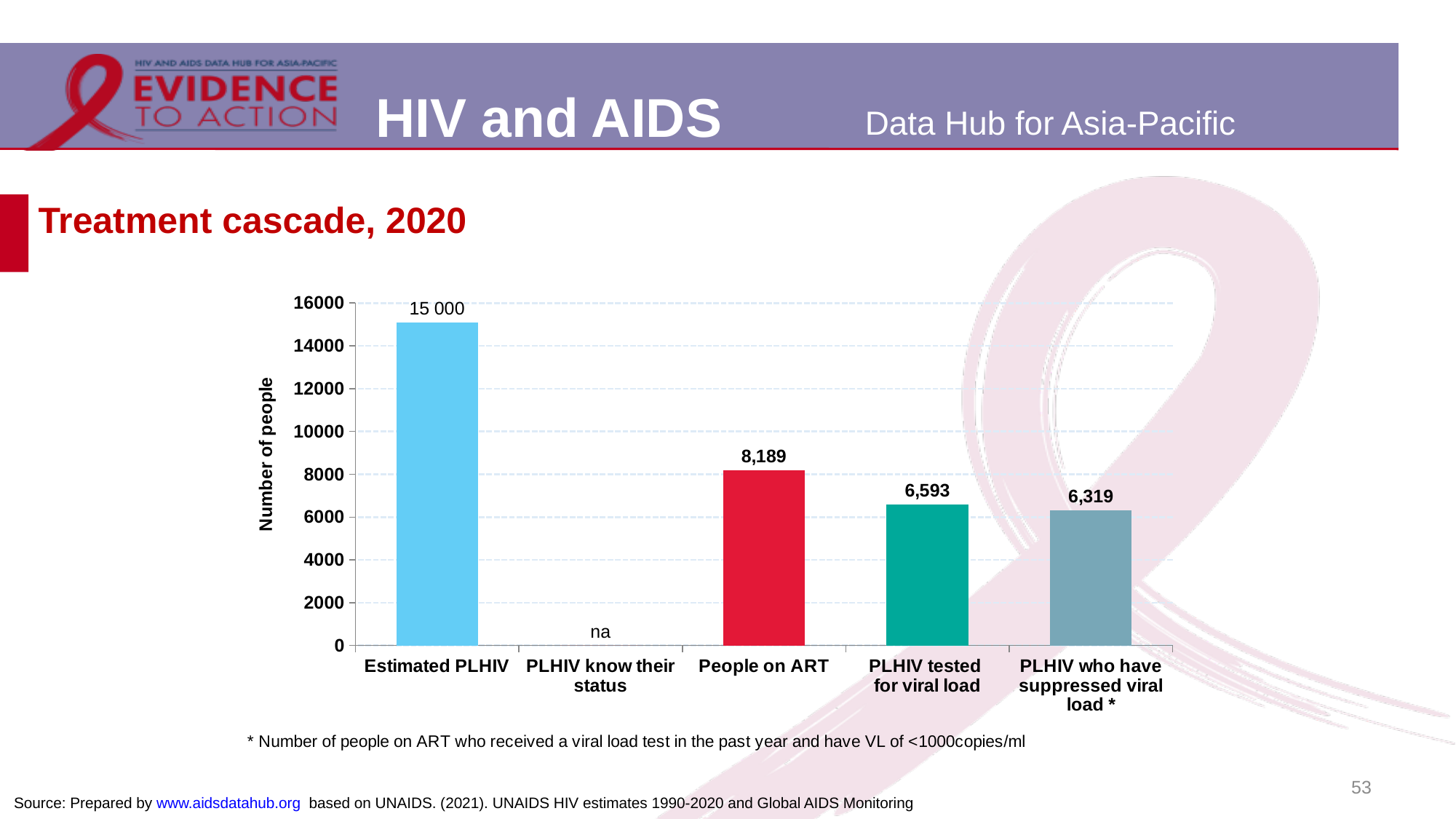
What is the value for PLHIV tested for viral load? 6,593 What is the value for Estimated PLHIV? 15 000 Among the categories with a numeric value, which has the lowest value? PLHIV who have suppressed viral load Which category has the highest value? Estimated PLHIV What is the difference between Estimated PLHIV and People on ART? 6,811 What is the difference between People on ART and PLHIV tested for viral load? 1,596 What is the value for People on ART? 8,189 Which is larger, PLHIV tested for viral load or PLHIV who have suppressed viral load? PLHIV tested for viral load What kind of chart is this? Bar chart What is shown for PLHIV know their status? na What is the value for PLHIV who have suppressed viral load? 6,319 How many categories are shown on the x axis? 5